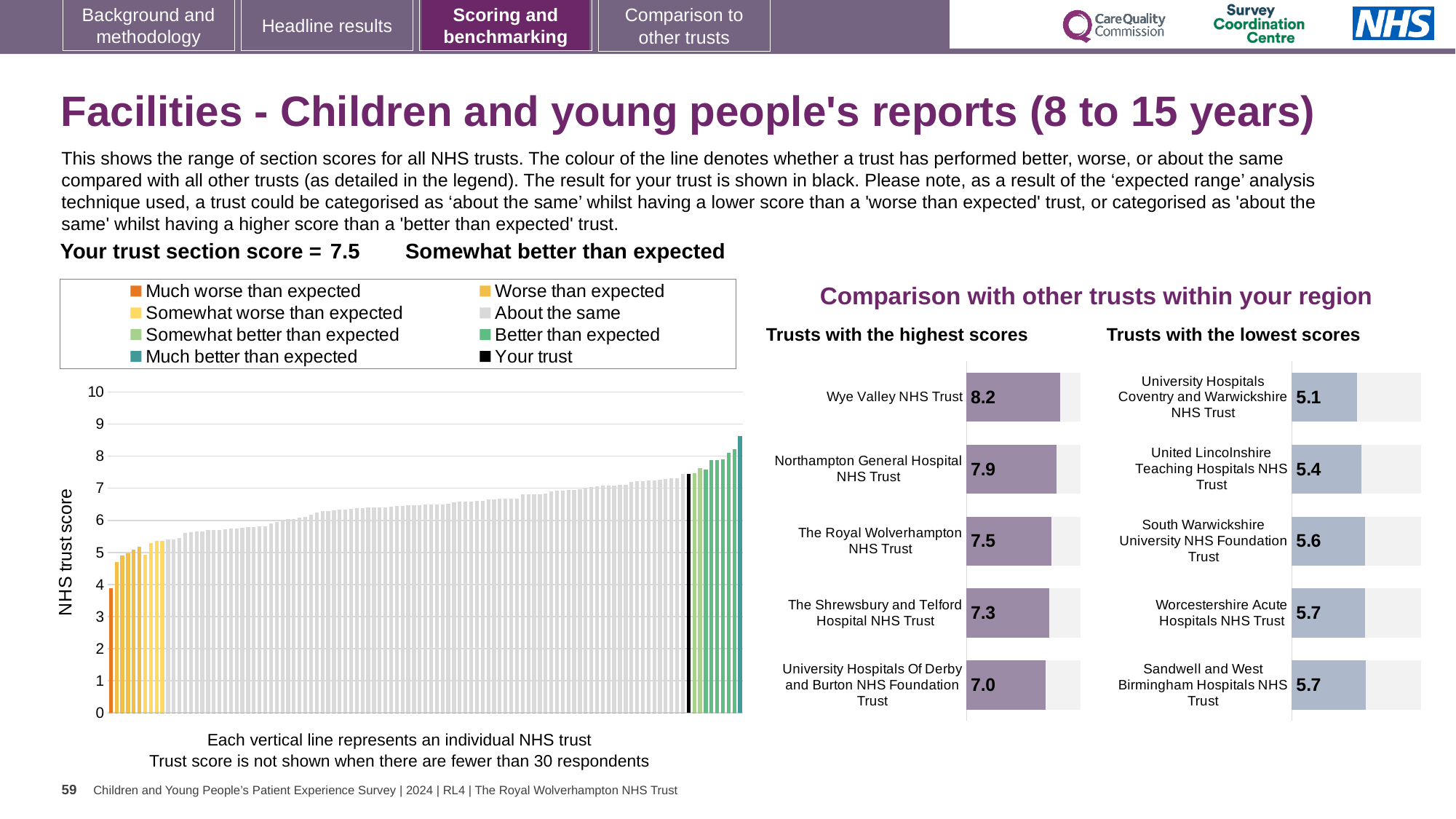
How many trusts are shown in the 'Trusts with the lowest scores' chart? 5 In the 'Trusts with the highest scores' chart, which trust has the highest score? Wye Valley NHS Trust In the large chart on the left, is the value for the black 'Your trust' bar greater or less than 7? greater In the 'Trusts with the highest scores' chart, what is the score for Wye Valley NHS Trust? 8.2 How many entries does the legend of the large chart on the left list? 8 In the 'Trusts with the lowest scores' chart, which has the larger score: United Lincolnshire Teaching Hospitals NHS Trust or South Warwickshire University NHS Foundation Trust? South Warwickshire University NHS Foundation Trust In the 'Trusts with the lowest scores' chart, what is the score for University Hospitals Coventry and Warwickshire NHS Trust? 5.1 In the 'Trusts with the lowest scores' chart, which trust has the lowest score? University Hospitals Coventry and Warwickshire NHS Trust In the large chart on the left, do the trust scores rise or fall from left to right? Rise In the 'Trusts with the highest scores' chart, what is the score for The Shrewsbury and Telford Hospital NHS Trust? 7.3 In the 'Trusts with the highest scores' chart, what is the difference between the scores of Wye Valley NHS Trust and University Hospitals Of Derby and Burton NHS Foundation Trust? 1.2 What type of chart is the large chart on the left showing NHS trust scores? Bar chart